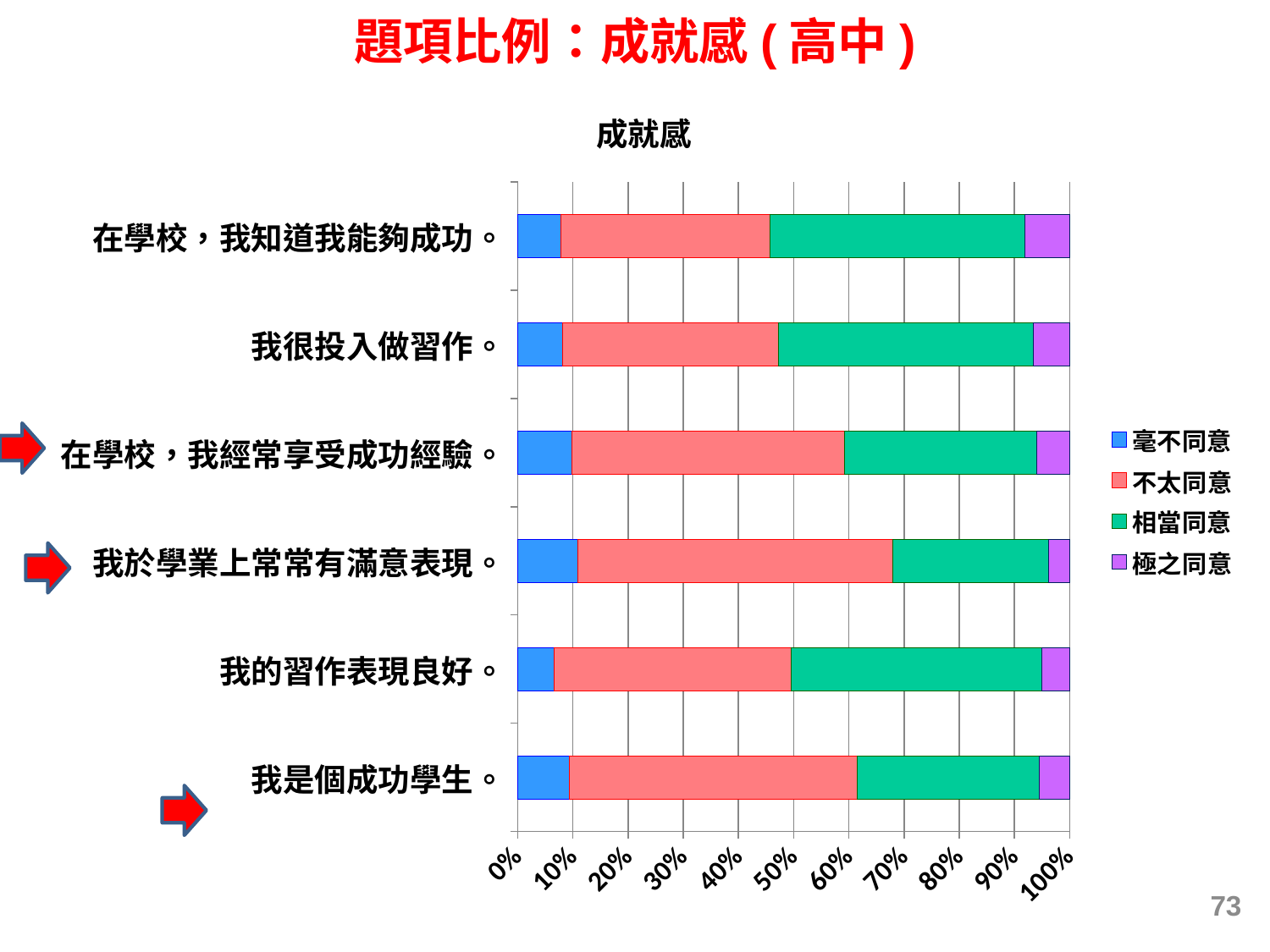
What is the title of the chart? 成就感 Is the 毫不同意 share for 我的習作表現良好 greater or less than 10%? less What kind of chart is shown on the slide? stacked bar chart Is the 不太同意 share for 我於學業上常常有滿意表現 greater or less than 50%? greater Which legend entry is shown in green? 相當同意 How many series does the legend list? 4 Which has the larger 相當同意 segment: 我很投入做習作 or 我於學業上常常有滿意表現? 我很投入做習作 Which has the larger 不太同意 segment: 我於學業上常常有滿意表現 or 在學校，我知道我能夠成功? 我於學業上常常有滿意表現 Is the 極之同意 share for 我於學業上常常有滿意表現 greater or less than 10%? less How many statements (categories) are plotted in the chart? 6 Which statement has the largest 不太同意 segment? 我於學業上常常有滿意表現